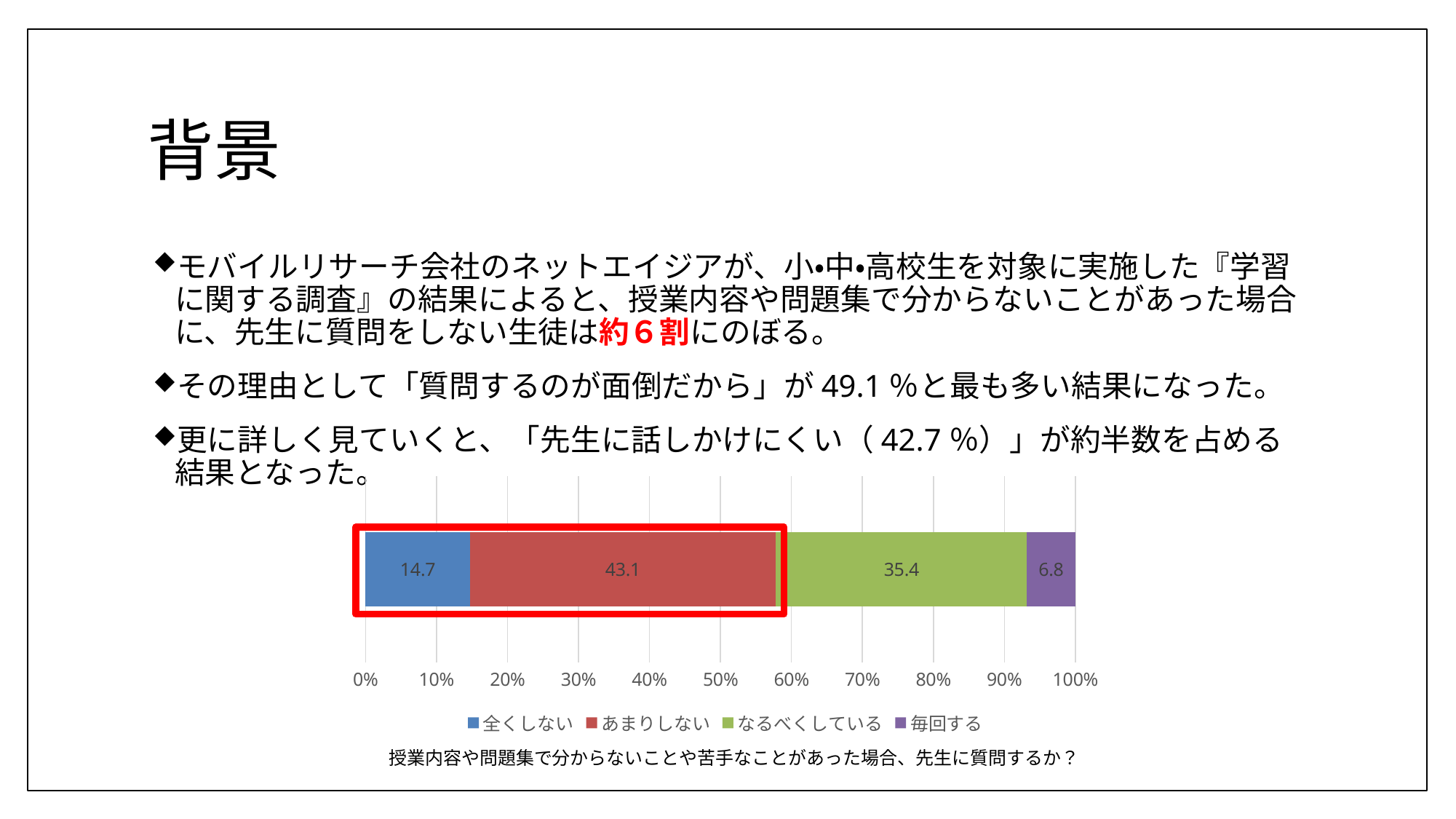
What kind of chart is shown on the slide? Stacked bar chart What is the combined value of the two segments inside the red box (全くしない and あまりしない)? 57.8 What is the value shown for あまりしない in the stacked bar? 43.1 How many series does the legend list? 4 What is the value shown for 全くしない in the stacked bar? 14.7 What is the value shown for なるべくしている in the stacked bar? 35.4 What colour is the segment for なるべくしている? Green What is the difference between the values for あまりしない and なるべくしている? 7.7 What is the value shown for 毎回する in the stacked bar? 6.8 Which response category has the smallest segment in the bar? 毎回する Which response category has the largest segment in the bar? あまりしない Which is larger, the value for 全くしない or the value for 毎回する? 全くしない